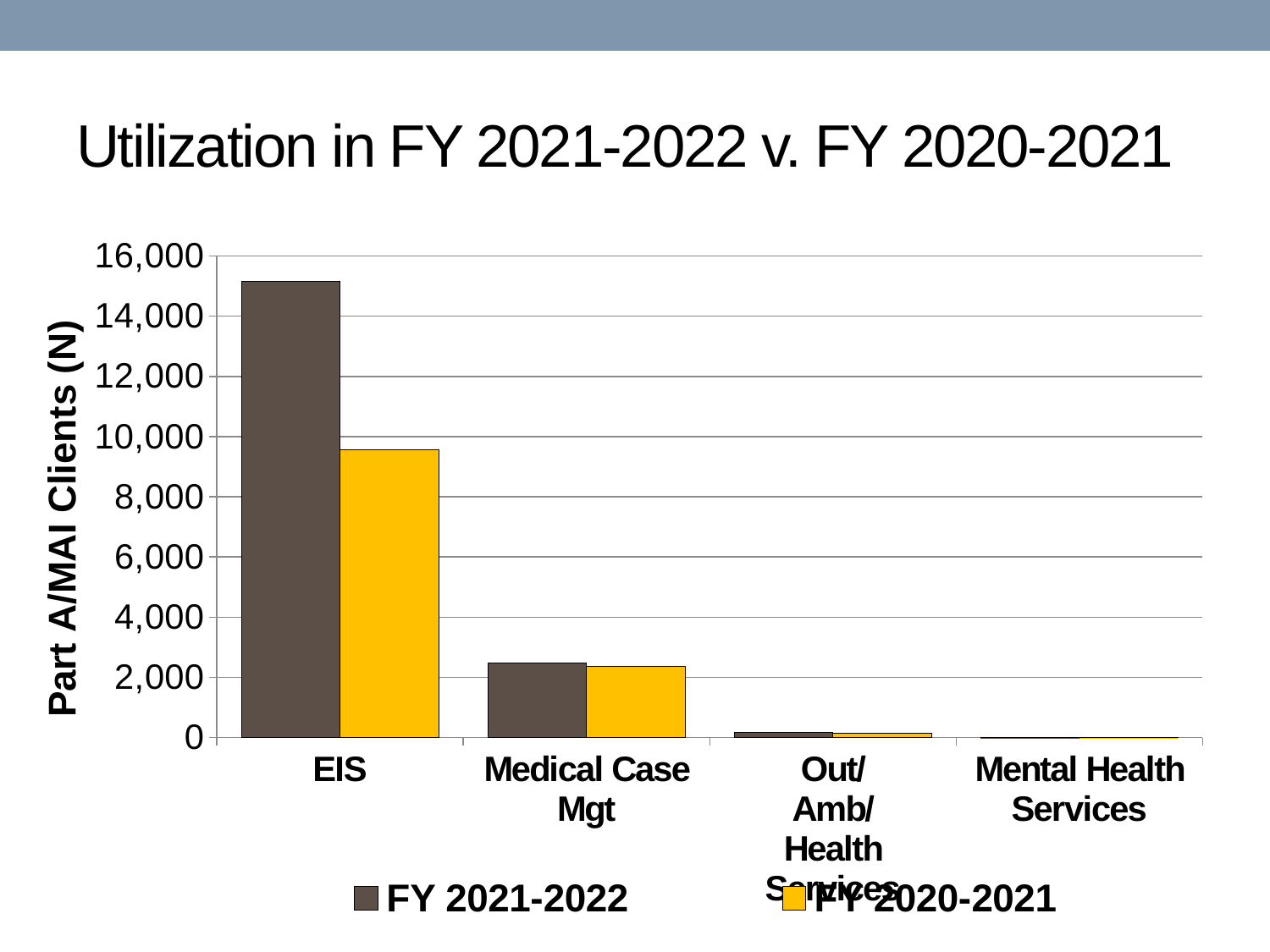
How many series does the legend list? 2 How many service categories are shown on the x axis? 4 What kind of chart is shown on the slide? bar chart Is the FY 2021-2022 value for Out/Amb/Health Services greater or less than 2,000? less Is the FY 2021-2022 value for Medical Case Mgt greater or less than 2,000? greater What is the title of the chart? Utilization in FY 2021-2022 v. FY 2020-2021 Which category has the lowest value for FY 2020-2021? Mental Health Services What is the label on the y axis? Part A/MAI Clients (N) Is the FY 2021-2022 value for EIS greater or less than 14,000? greater For EIS, which series has the larger value, FY 2021-2022 or FY 2020-2021? FY 2021-2022 Which category has the highest value for FY 2021-2022? EIS